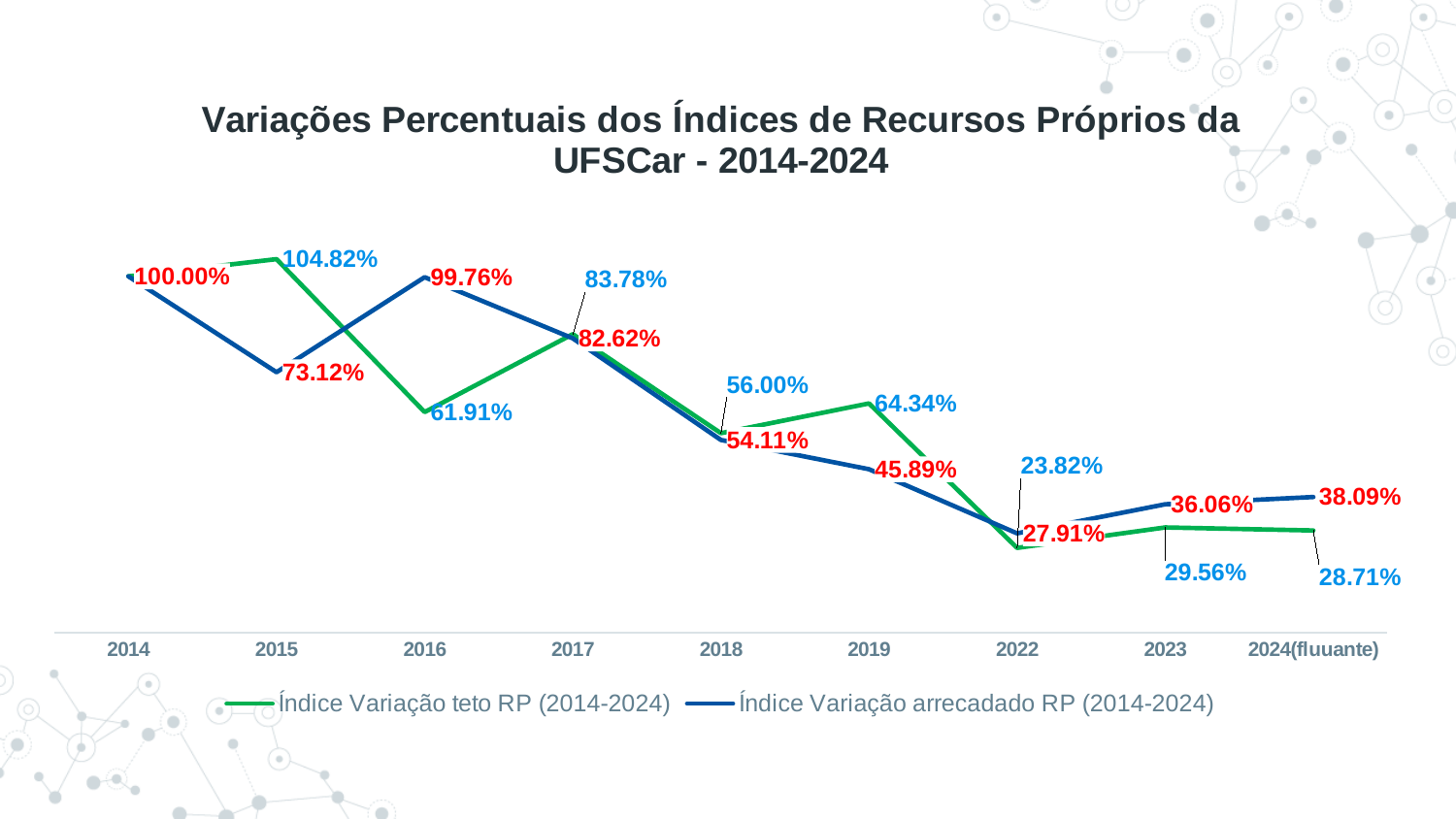
What is the value of Índice Variação teto RP (2014-2024) in 2022? 23.82% In 2023, which series has the higher value: Índice Variação teto RP or Índice Variação arrecadado RP? Índice Variação arrecadado RP (2014-2024) What is the difference between Índice Variação teto RP and Índice Variação arrecadado RP in 2019? 18.45 percentage points Overall, do the values of Índice Variação arrecadado RP (2014-2024) rise or fall from 2014 to 2024(fluuante)? Fall How many years are shown on the x axis? 9 What kind of chart is shown on the slide? Line chart In which year does Índice Variação teto RP (2014-2024) reach its highest value? 2015 How many series does the legend list? 2 What is the value of Índice Variação arrecadado RP (2014-2024) in 2024(fluuante)? 38.09% What is the value of Índice Variação teto RP (2014-2024) in 2015? 104.82% In which year does Índice Variação arrecadado RP (2014-2024) reach its lowest value? 2022 What is the value of Índice Variação arrecadado RP (2014-2024) in 2016? 99.76%